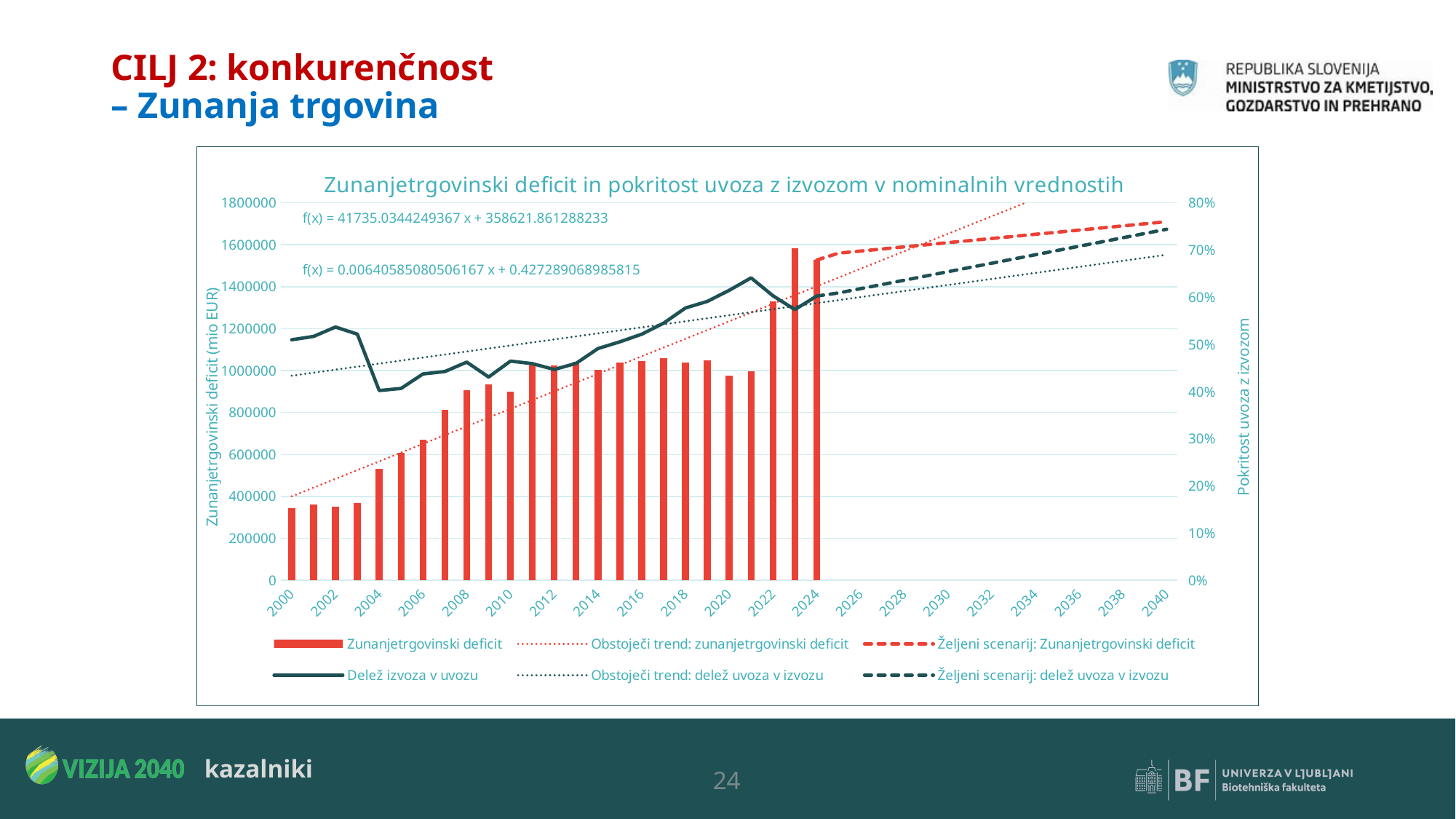
In which year is the Zunanjetrgovinski deficit bar the highest? 2023 How many series does the legend list? 6 Is the Zunanjetrgovinski deficit bar for 2000 greater or less than 400000? less How many years have a Zunanjetrgovinski deficit bar plotted? 25 Is the Zunanjetrgovinski deficit bar for 2010 greater or less than 1000000? less What is the first trend-line equation printed on the chart? f(x) = 41735.0344249367 x + 358621.861288233 Which year has a larger Zunanjetrgovinski deficit bar, 2004 or 2008? 2008 What kind of chart is shown on the slide? A combined bar and line chart Do the Zunanjetrgovinski deficit bars generally rise or fall from 2000 to 2024? rise What is the title of the chart? Zunanjetrgovinski deficit in pokritost uvoza z izvozom v nominalnih vrednostih Is the Delež izvoza v uvozu line for 2004 greater or less than 50%? less